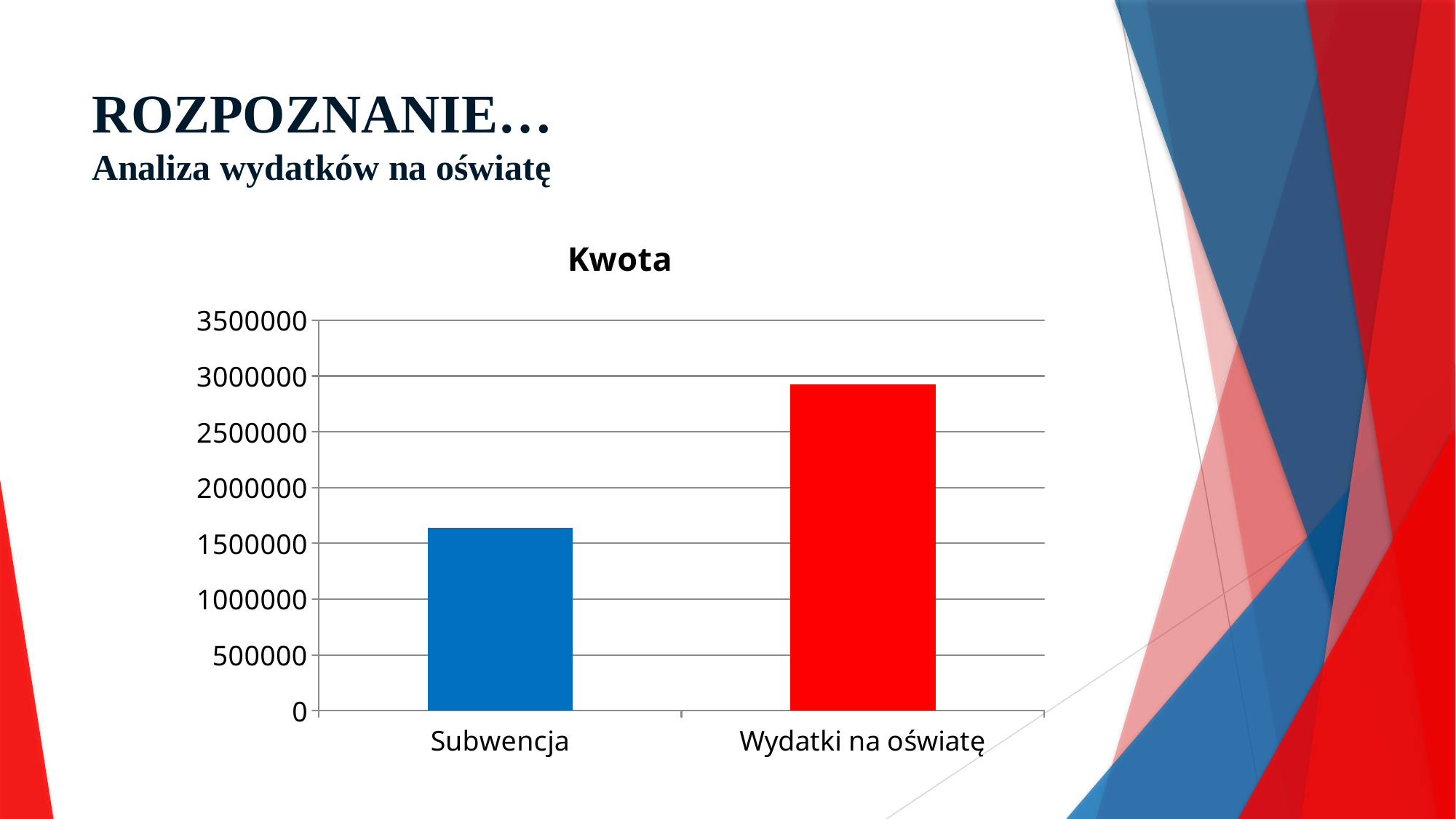
Is the value for Wydatki na oświatę greater or less than 2500000? greater What colour is the bar for Wydatki na oświatę? red What is the highest value shown on the vertical axis? 3500000 How many categories are plotted in the chart? 2 Is the value for Subwencja greater or less than 1500000? greater Which is larger, the value for Subwencja or the value for Wydatki na oświatę? Wydatki na oświatę Is the value for Wydatki na oświatę greater or less than 3000000? less What is the title of the chart? Kwota Which category has the highest value? Wydatki na oświatę What kind of chart is shown on the slide? bar chart Which category has the lowest value? Subwencja